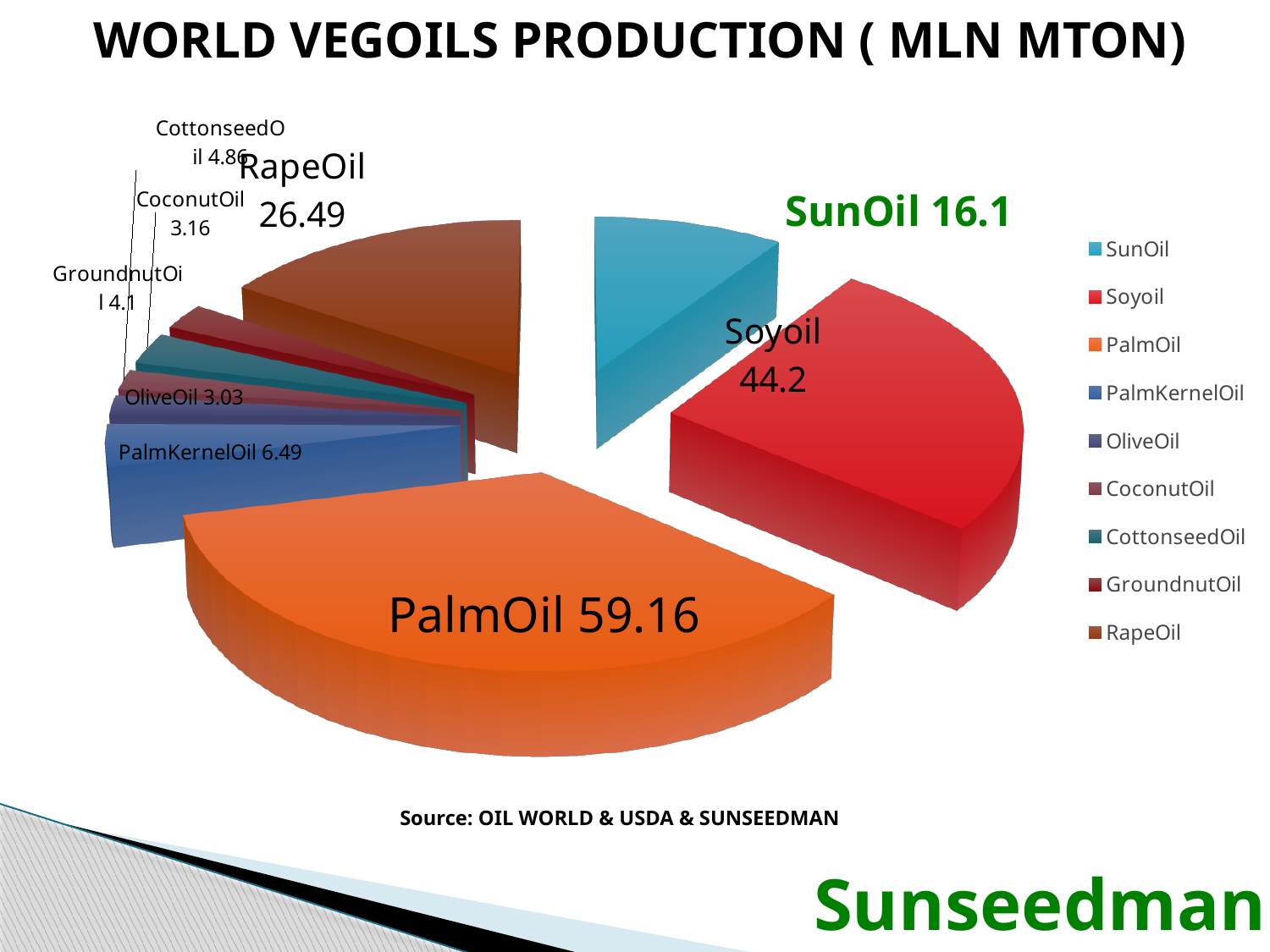
What is the value for PalmOil? 59.16 How many categories does the legend list? 9 What is the value for PalmKernelOil? 6.49 What is the difference between the PalmOil and Soyoil values? 14.96 What type of chart is shown on the slide? pie chart What is the title of the chart? WORLD VEGOILS PRODUCTION ( MLN MTON) Which is larger, RapeOil or SunOil? RapeOil What is the value for SunOil? 16.1 What is the value for RapeOil? 26.49 What is the value for Soyoil? 44.2 Which oil has the smallest value in the chart? OliveOil Which oil has the largest share of world vegoils production? PalmOil